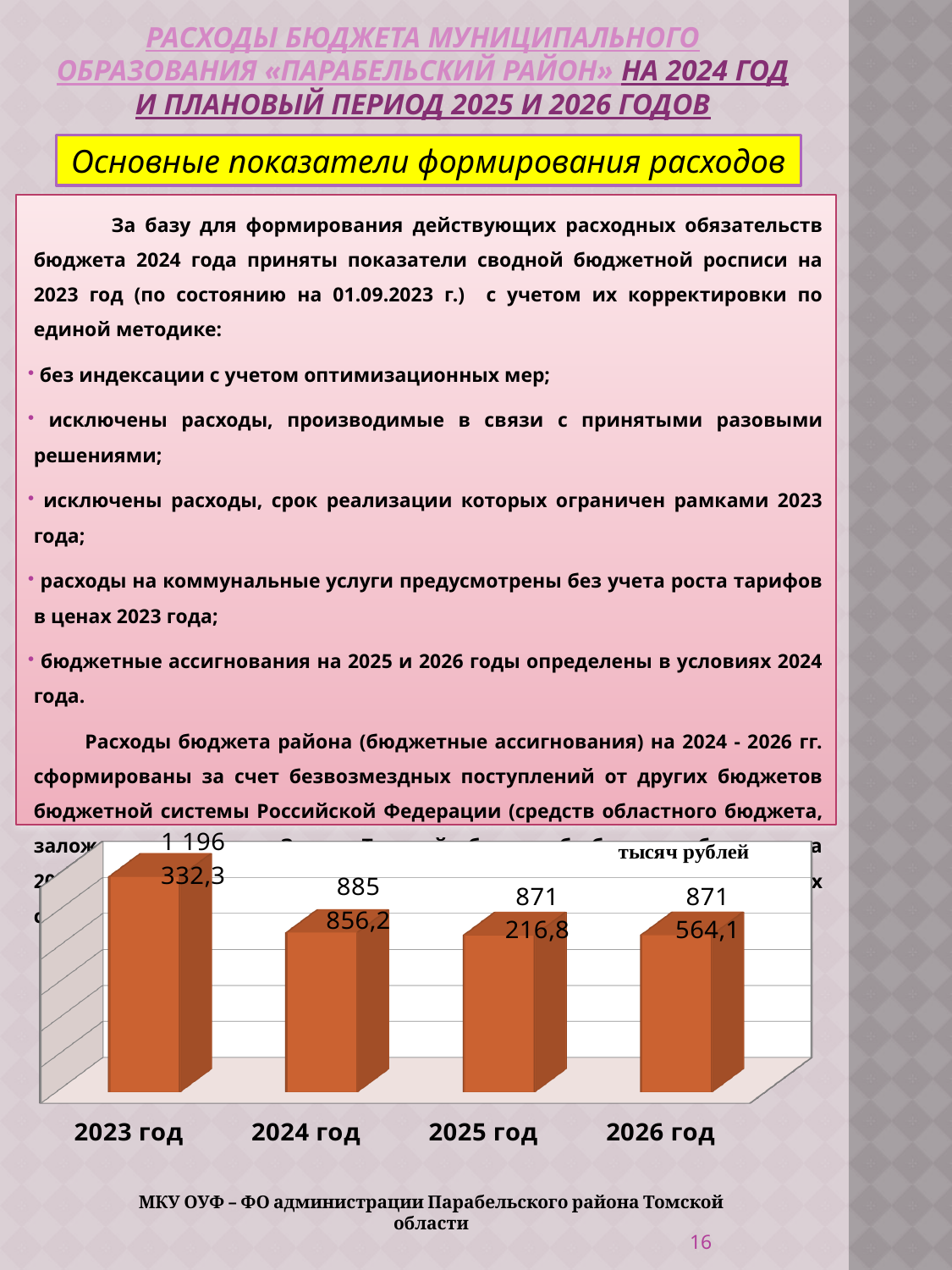
What kind of chart is shown on the slide? bar chart Which year has the highest value on the chart? 2023 год What is the value for 2025 год on the chart? 871 216,8 What is the value for 2026 год on the chart? 871 564,1 What is the difference between the values for 2023 год and 2024 год? 310 476,1 Do the values rise or fall from 2023 год to 2025 год? fall How many years (categories) are shown on the chart? 4 Which is larger, the value for 2024 год or the value for 2025 год? 2024 год What unit is indicated in the top right corner of the chart? тысяч рублей What is the value for 2023 год on the chart? 1 196 332,3 What is the difference between the values for 2024 год and 2025 год? 14 639,4 What is the value for 2024 год on the chart? 885 856,2